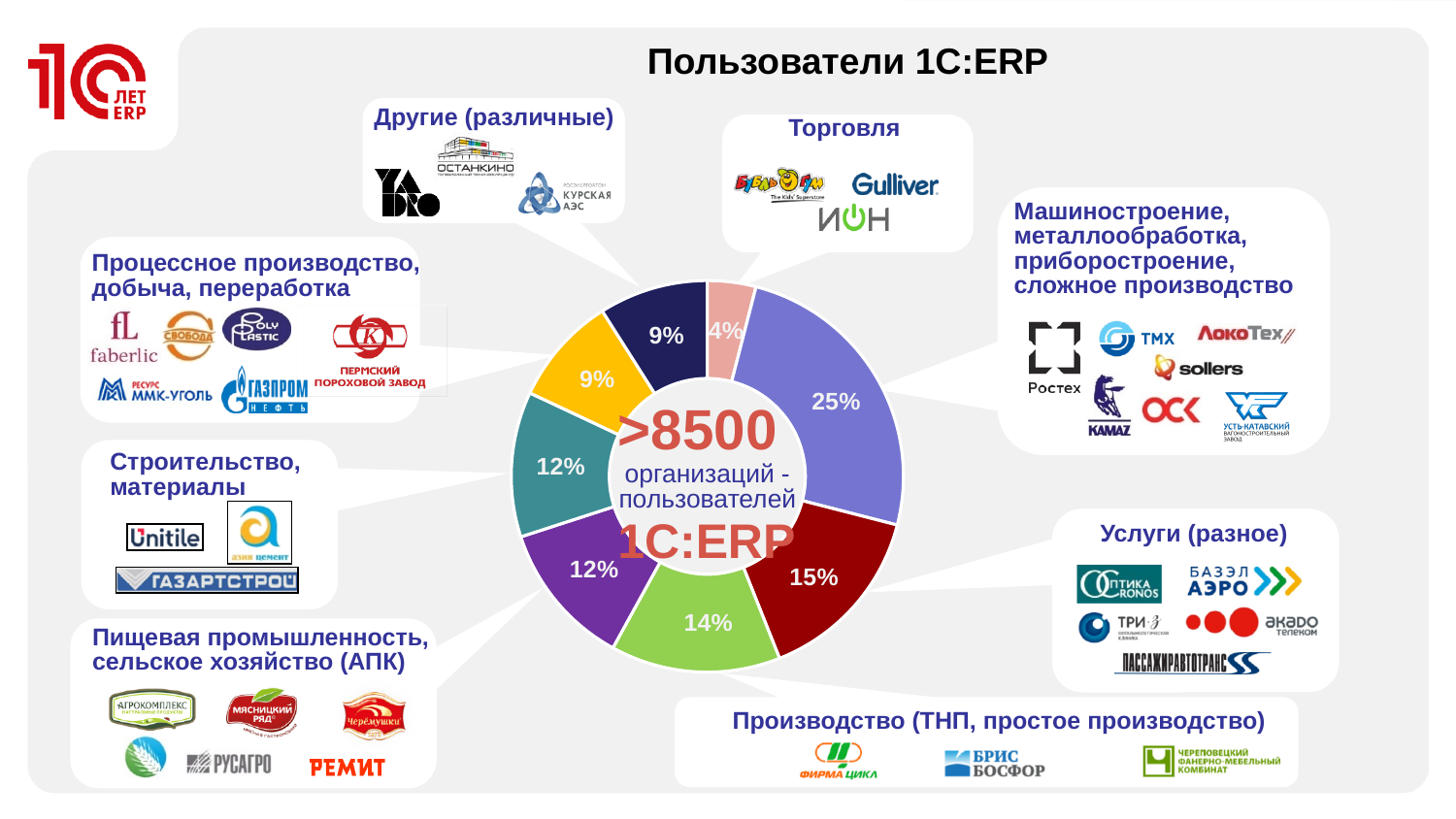
Which segment has a larger share: 'Производство (ТНП, простое производство)' or 'Торговля'? Производство (ТНП, простое производство) What share of 1C:ERP users belongs to the segment 'Машиностроение, металлообработка, приборостроение, сложное производство'? 25% How many segments does the donut chart have? 8 Which segment has the largest share of 1C:ERP users? Машиностроение, металлообработка, приборостроение, сложное производство What number of user organizations is shown in the center of the donut chart? >8500 What share of 1C:ERP users belongs to the segment 'Торговля'? 4% What share of 1C:ERP users belongs to the segment 'Производство (ТНП, простое производство)'? 14% What is the title of the slide containing the chart? Пользователи 1С:ERP What is the difference in percentage points between the 'Машиностроение' segment and the 'Услуги (разное)' segment? 10 percentage points Which segment has the smallest share of 1C:ERP users? Торговля What kind of chart is shown on the slide? Donut (pie) chart What share of 1C:ERP users belongs to the segment 'Услуги (разное)'? 15%